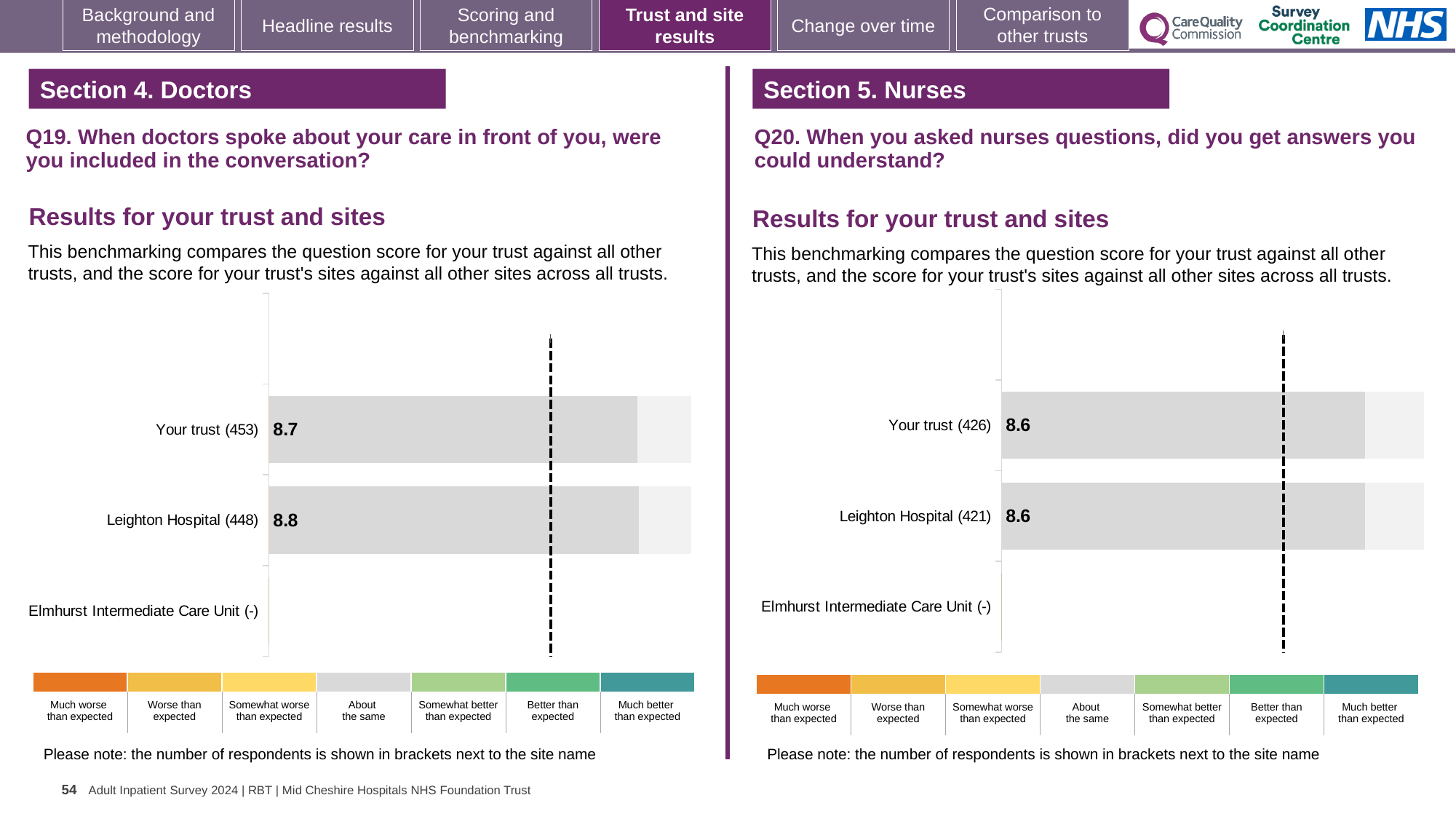
On the Q19 chart (left), what is the difference between the Leighton Hospital score and the Your trust score? 0.1 On the Q19 chart (left), how many respondents are shown in brackets for Your trust? 453 On the Q20 chart (right), which site has no score shown (marked with a dash)? Elmhurst Intermediate Care Unit On the Q19 chart (left), what is the score for Your trust? 8.7 On the Q19 chart (left), what is the score for Leighton Hospital? 8.8 How many site/trust rows are listed on the Q19 chart (left)? 3 On the Q20 chart (right), what is the score for Your trust? 8.6 On the Q20 chart (right), what is the difference between the Your trust score and the Leighton Hospital score? 0 What type of chart is used on the Q20 chart (right)? Bar chart On the Q20 chart (right), how many respondents are shown in brackets for Leighton Hospital? 421 On the Q19 chart (left), which has the higher score, Your trust or Leighton Hospital? Leighton Hospital On the Q20 chart (right), what is the score for Leighton Hospital? 8.6